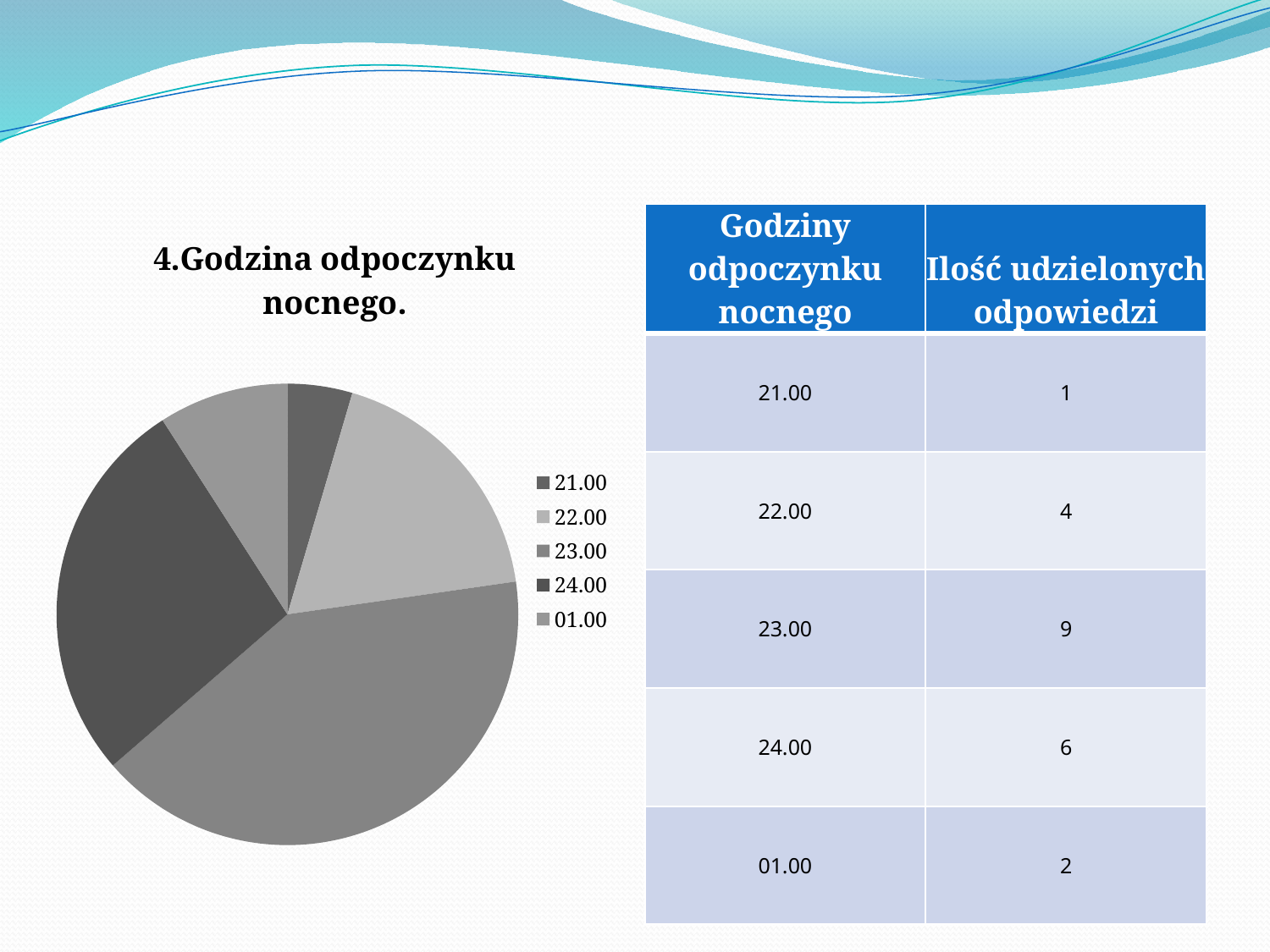
How many responses are recorded for 23.00? 9 Which category has the largest slice of the pie? 23.00 Which slice is larger, 24.00 or 22.00? 24.00 Which legend entry is listed last? 01.00 How many categories does the pie chart have? 5 Which category has the smallest slice of the pie? 21.00 What kind of chart is shown on the slide? pie chart How many responses are recorded for 01.00? 2 What is the difference between the number of responses for 23.00 and for 24.00? 3 What is the total number of responses across all categories? 22 What is the title of the chart? 4.Godzina odpoczynku nocnego. How many responses are recorded for 24.00? 6